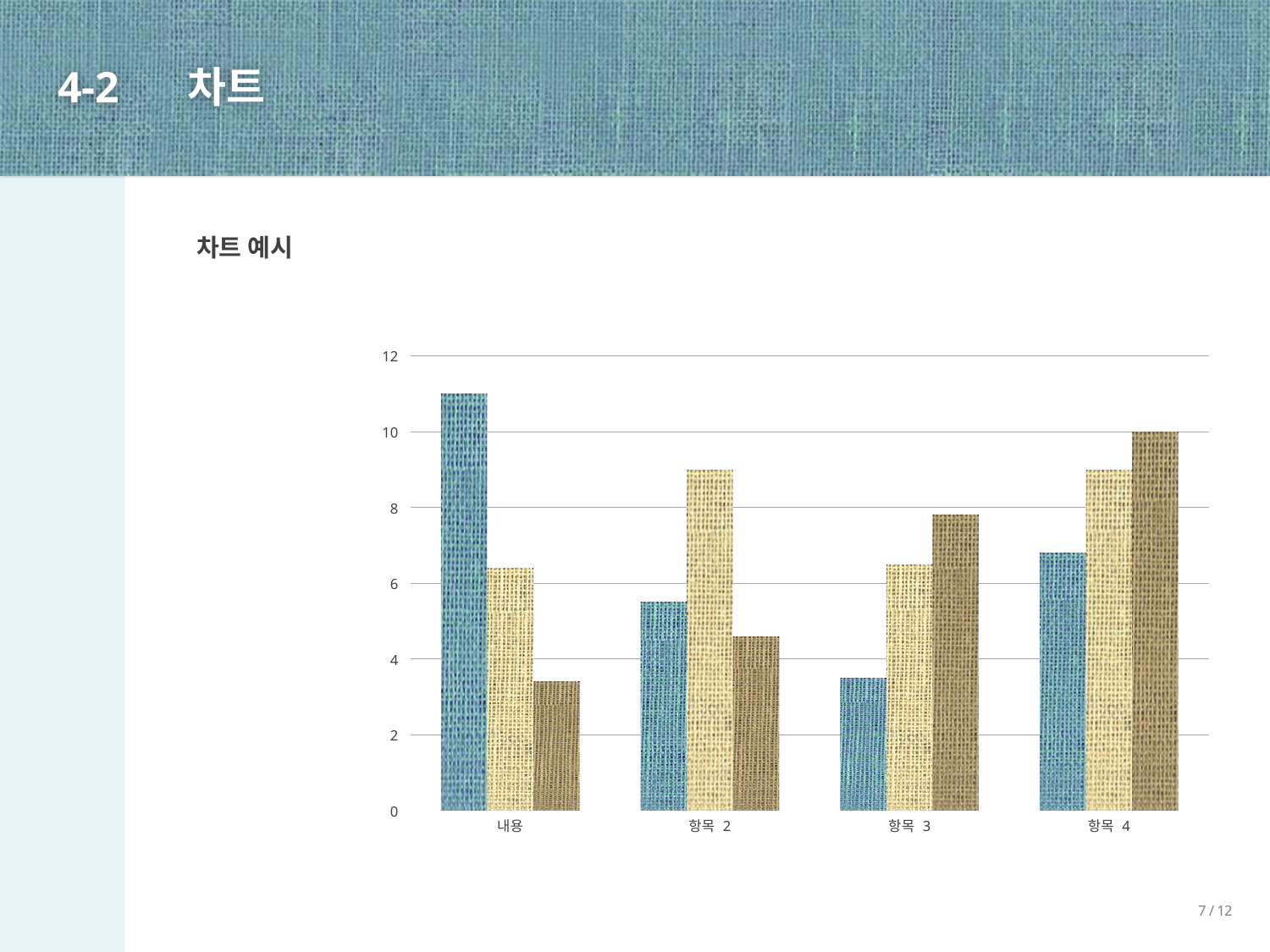
Within the 항목 4 group, which bar is the tallest? the rightmost (dark tan) bar What kind of chart is shown on the slide? bar chart How many categories are shown on the x axis of the chart? 4 Is the value of the light tan bar for 항목 2 greater or less than 8? greater Is the value of the dark tan bar for 내용 greater or less than 4? less Which is larger: the blue bar for 내용 or the blue bar for 항목 2? 내용 Within the 항목 2 group, which bar is the tallest? the middle (light tan) bar Which category has the tallest bar in the chart? 내용 Do the dark tan (rightmost) bars rise or fall from 내용 to 항목 4? rise Is the value of the blue bar for 항목 3 greater or less than 4? less How many bars are plotted for each category in the chart? 3